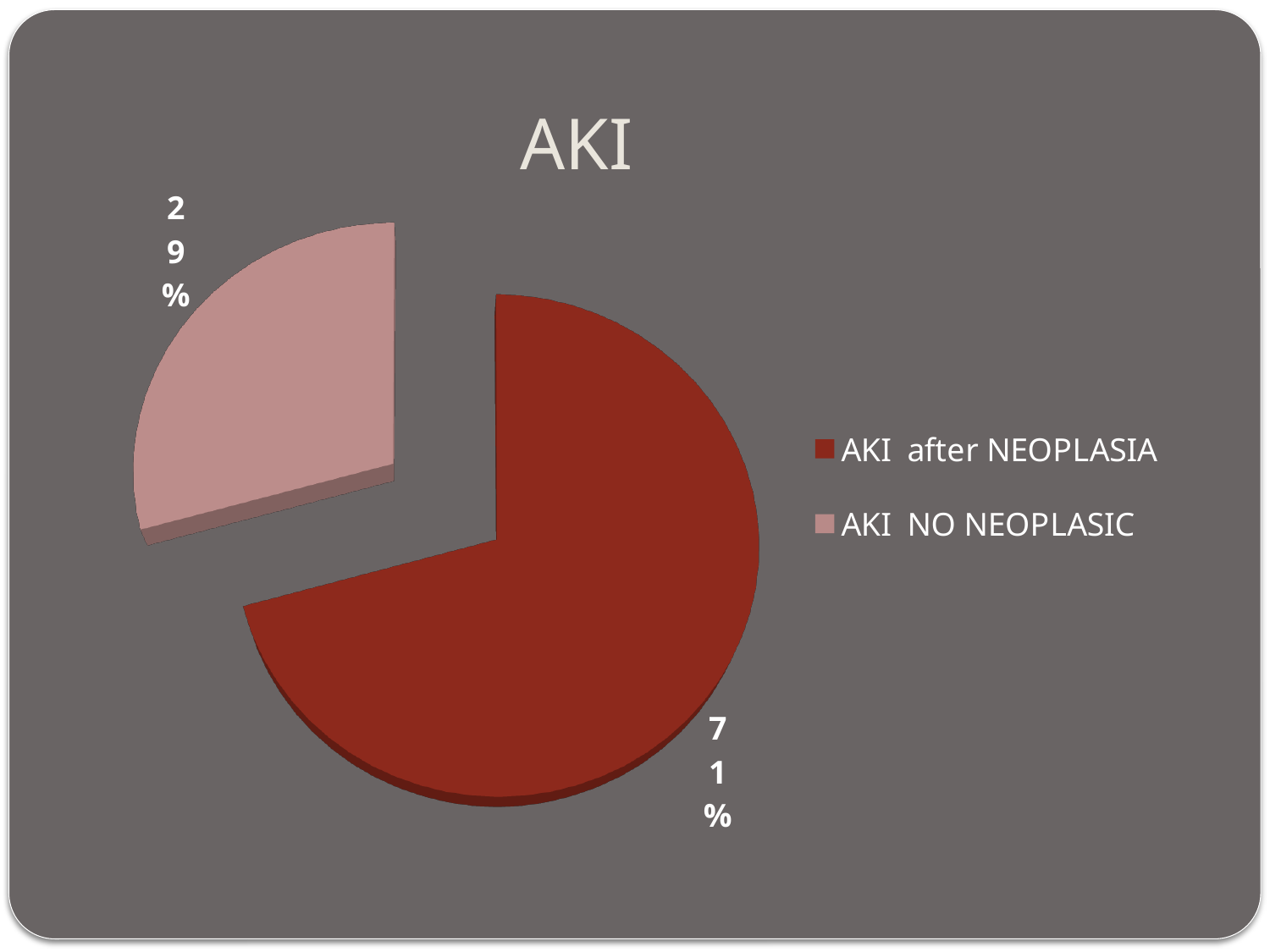
What is the title of the chart? AKI Which slice is the largest? AKI after NEOPLASIA How many slices does the pie chart have? 2 What kind of chart is shown on the slide? pie chart Which legend entry is shown in the lighter pink colour? AKI NO NEOPLASIC What is the difference in percentage points between the AKI after NEOPLASIA slice and the AKI NO NEOPLASIC slice? 42 Which slice is the smallest? AKI NO NEOPLASIC What share of the pie is labelled for AKI NO NEOPLASIC? 29% How many entries does the legend list? 2 What share of the pie is labelled for AKI after NEOPLASIA? 71% Which is larger, the AKI after NEOPLASIA slice or the AKI NO NEOPLASIC slice? AKI after NEOPLASIA